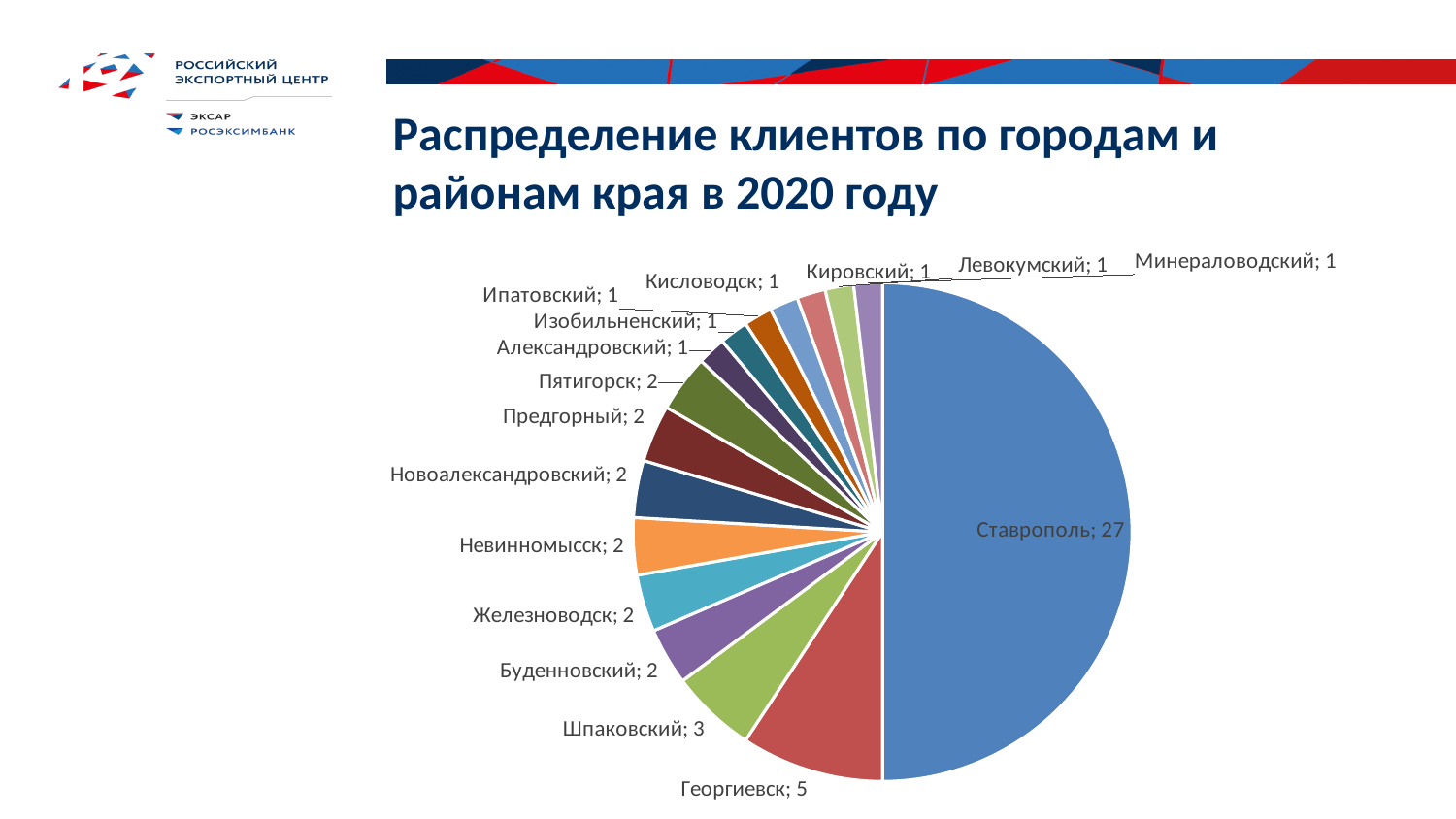
How many cities and districts are shown in the pie chart? 16 What is the difference between the values for Георгиевск and Шпаковский? 2 What is the value shown for Невинномысск? 2 How many clients does the chart show for Ставрополь? 27 Which has a larger value, Шпаковский or Пятигорск? Шпаковский What is the value shown for Шпаковский? 3 What share of the pie does Ставрополь represent? 50% What is the value shown for Георгиевск? 5 Which city or district has the largest slice of the pie? Ставрополь What kind of chart is shown on the slide? pie chart What is the difference between the values for Ставрополь and Георгиевск? 22 What is the title of the chart on the slide? Распределение клиентов по городам и районам края в 2020 году